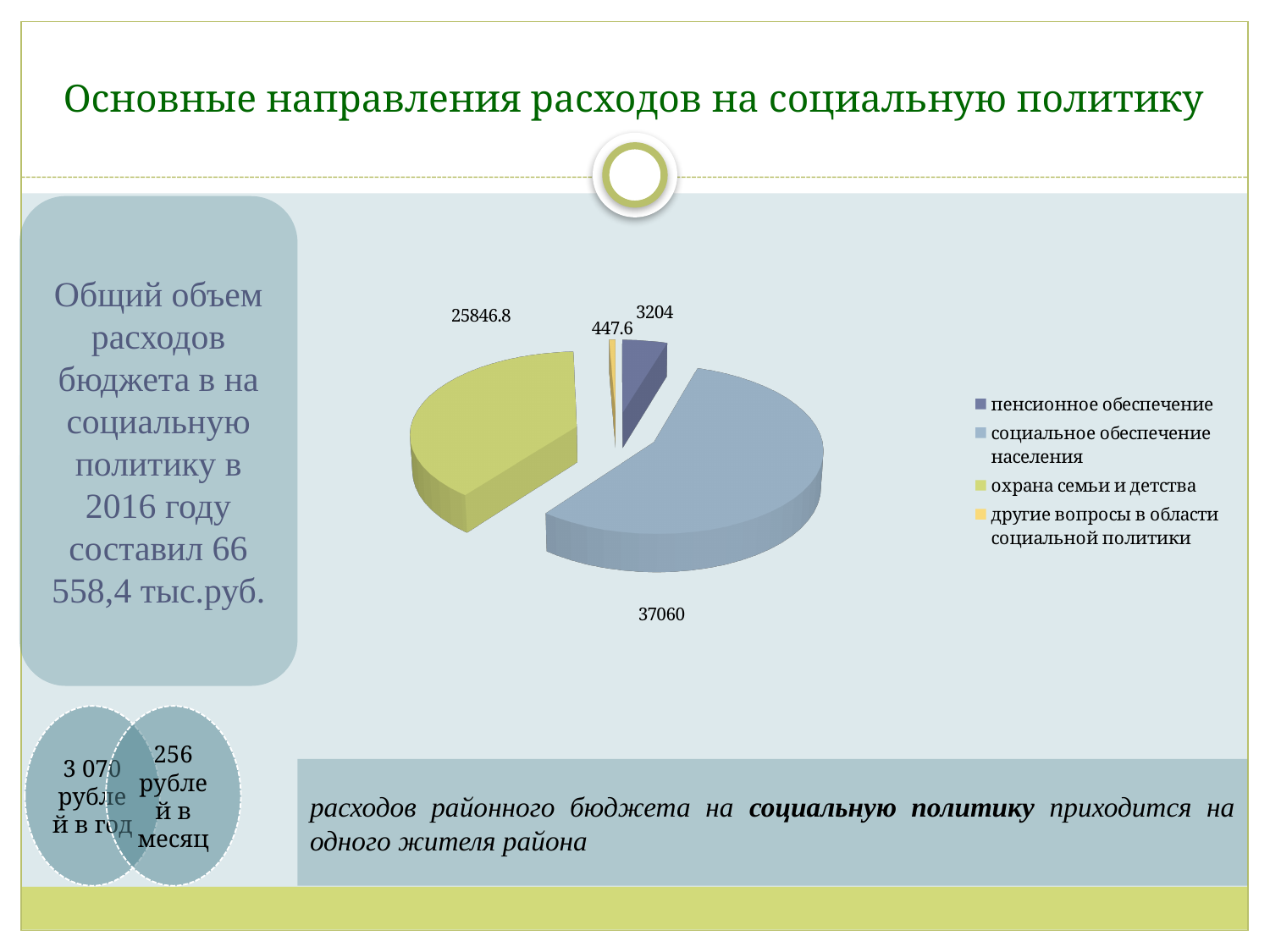
What colour is the slice for 'охрана семьи и детства' in the pie chart? yellow-green How many entries does the legend of the pie chart list? 4 What is the difference between the values for 'социальное обеспечение населения' and 'охрана семьи и детства'? 11213.2 Which is larger in the pie chart: 'пенсионное обеспечение' or 'другие вопросы в области социальной политики'? пенсионное обеспечение Which category has the smallest slice in the pie chart? другие вопросы в области социальной политики What is the value for 'охрана семьи и детства' in the pie chart? 25846.8 Which category has the largest slice in the pie chart? социальное обеспечение населения What is the value for 'социальное обеспечение населения' in the pie chart? 37060 How many slices does the pie chart have? 4 What is the value for 'пенсионное обеспечение' in the pie chart? 3204 What kind of chart is shown on the slide? pie chart What is the value for 'другие вопросы в области социальной политики' in the pie chart? 447.6